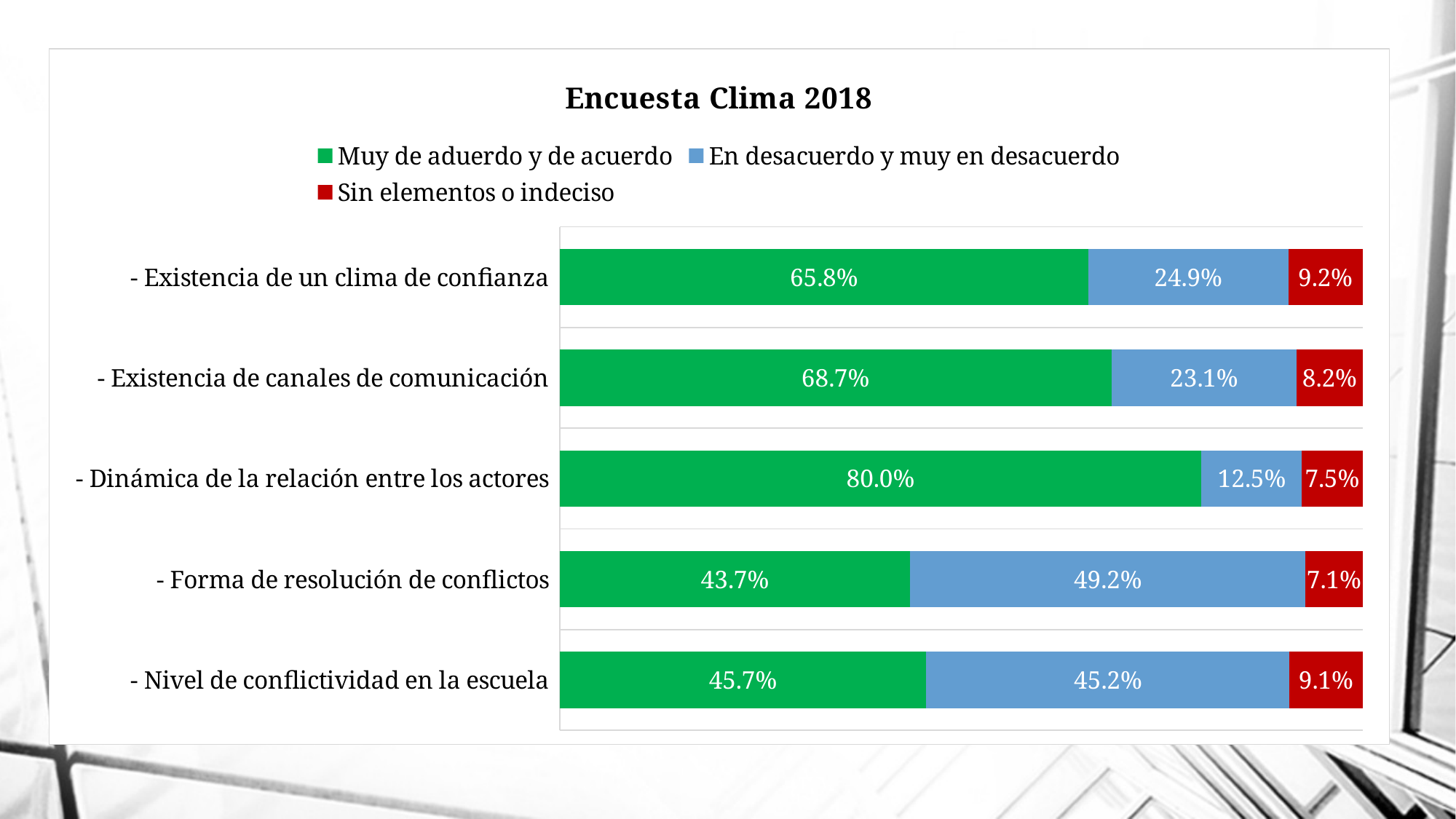
What is the 'En desacuerdo y muy en desacuerdo' value for 'Forma de resolución de conflictos'? 49.2% Which category has the lowest 'Sin elementos o indeciso' value? Forma de resolución de conflictos How many series does the legend list? 3 What is the difference between the 'Muy de aduerdo y de acuerdo' values for 'Existencia de canales de comunicación' and 'Existencia de un clima de confianza'? 2.9% What is the 'Sin elementos o indeciso' value for 'Existencia de un clima de confianza'? 9.2% How many categories are shown in the chart? 5 What kind of chart is shown on the slide? Stacked bar chart Which category has the highest 'Muy de aduerdo y de acuerdo' value? Dinámica de la relación entre los actores What colour represents the 'Sin elementos o indeciso' series? Red What is the 'Muy de aduerdo y de acuerdo' value for 'Dinámica de la relación entre los actores'? 80.0% What is the title of the chart? Encuesta Clima 2018 Which is larger: the 'En desacuerdo y muy en desacuerdo' value for 'Existencia de un clima de confianza' or for 'Dinámica de la relación entre los actores'? Existencia de un clima de confianza